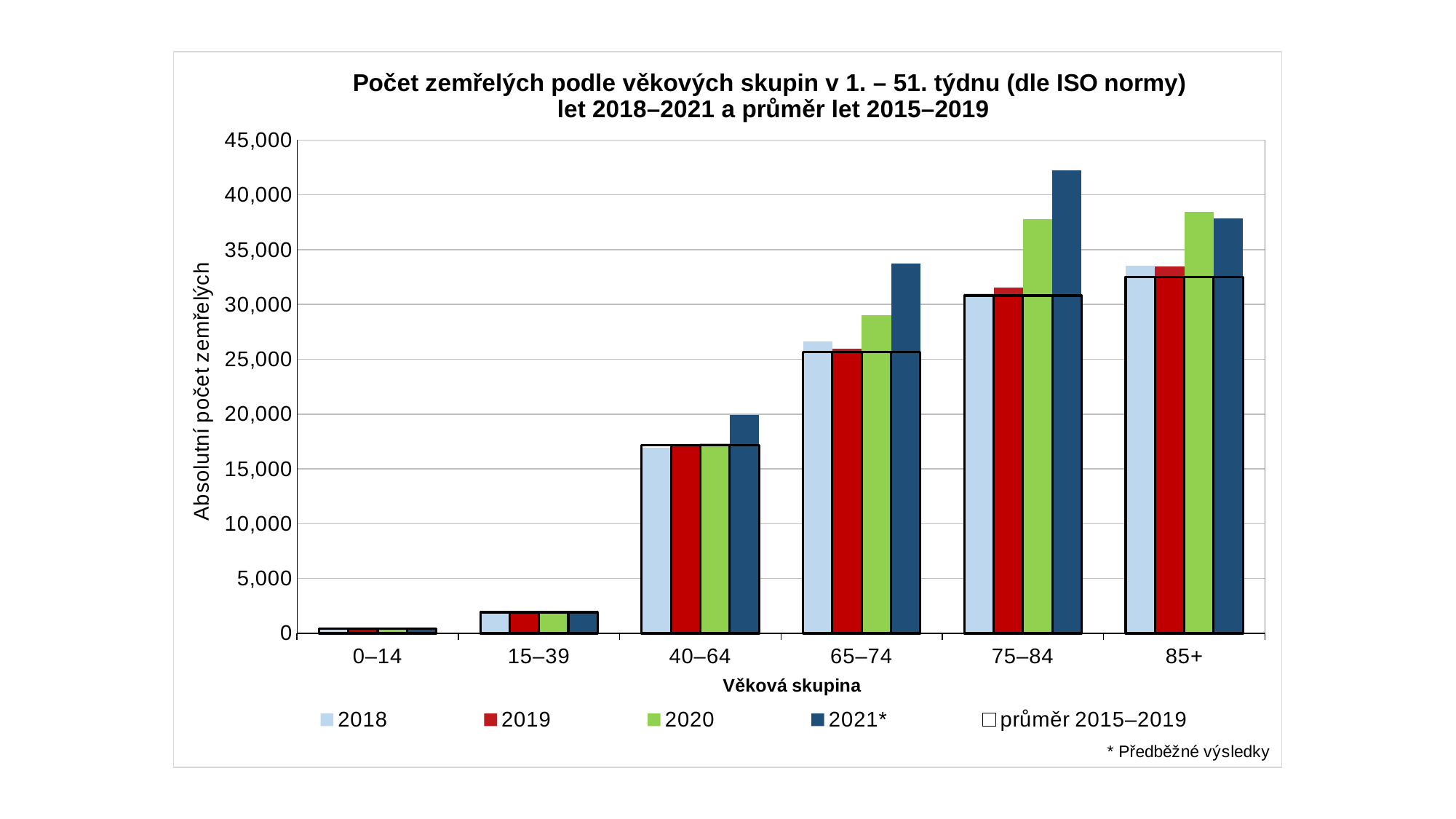
Is the 2021* value for the 65–74 age group greater or less than 30,000? greater Is the 2018 value for the 40–64 age group greater or less than 20,000? less For the 75–84 age group, which is larger: the 2020 value or the 2021* value? 2021* How many series does the legend list? 5 Is the 2020 value for the 85+ age group greater or less than 35,000? greater Which age group has the lowest value for the 2018 series? 0–14 What kind of chart is shown on the slide? bar chart For the 65–74 age group, which is larger: the 2018 value or the 2021* value? 2021* Which age group has the highest value for the 2021* series? 75–84 Do the 2018 values rise or fall along the x axis from the 0–14 group to the 85+ group? rise How many age groups are shown on the x axis? 6